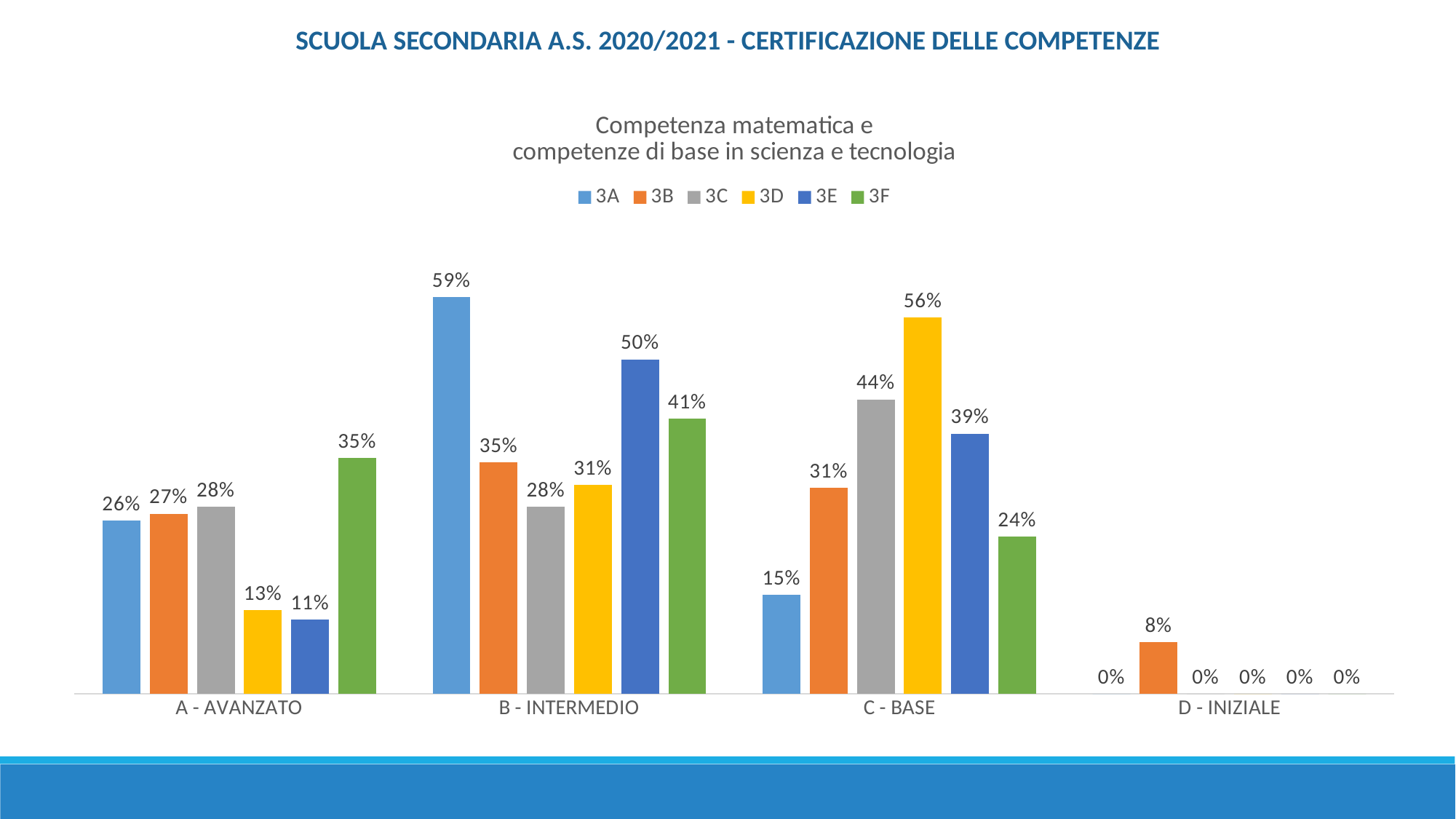
What is the value for 3E in the A - AVANZATO category? 11% What is the difference between the 3A and 3B values in the B - INTERMEDIO category? 24% What is the value for 3A in the B - INTERMEDIO category? 59% Which series has the lowest value in the C - BASE category? 3A What is the value for 3D in the C - BASE category? 56% What kind of chart is shown on the slide? Bar chart What is the title of the chart? Competenza matematica e competenze di base in scienza e tecnologia How many series does the legend list? 6 How many categories are shown on the x axis? 4 Which series has the highest value in the A - AVANZATO category? 3F What is the value for 3B in the D - INIZIALE category? 8% Which is larger in the C - BASE category: the value for 3C or the value for 3E? 3C